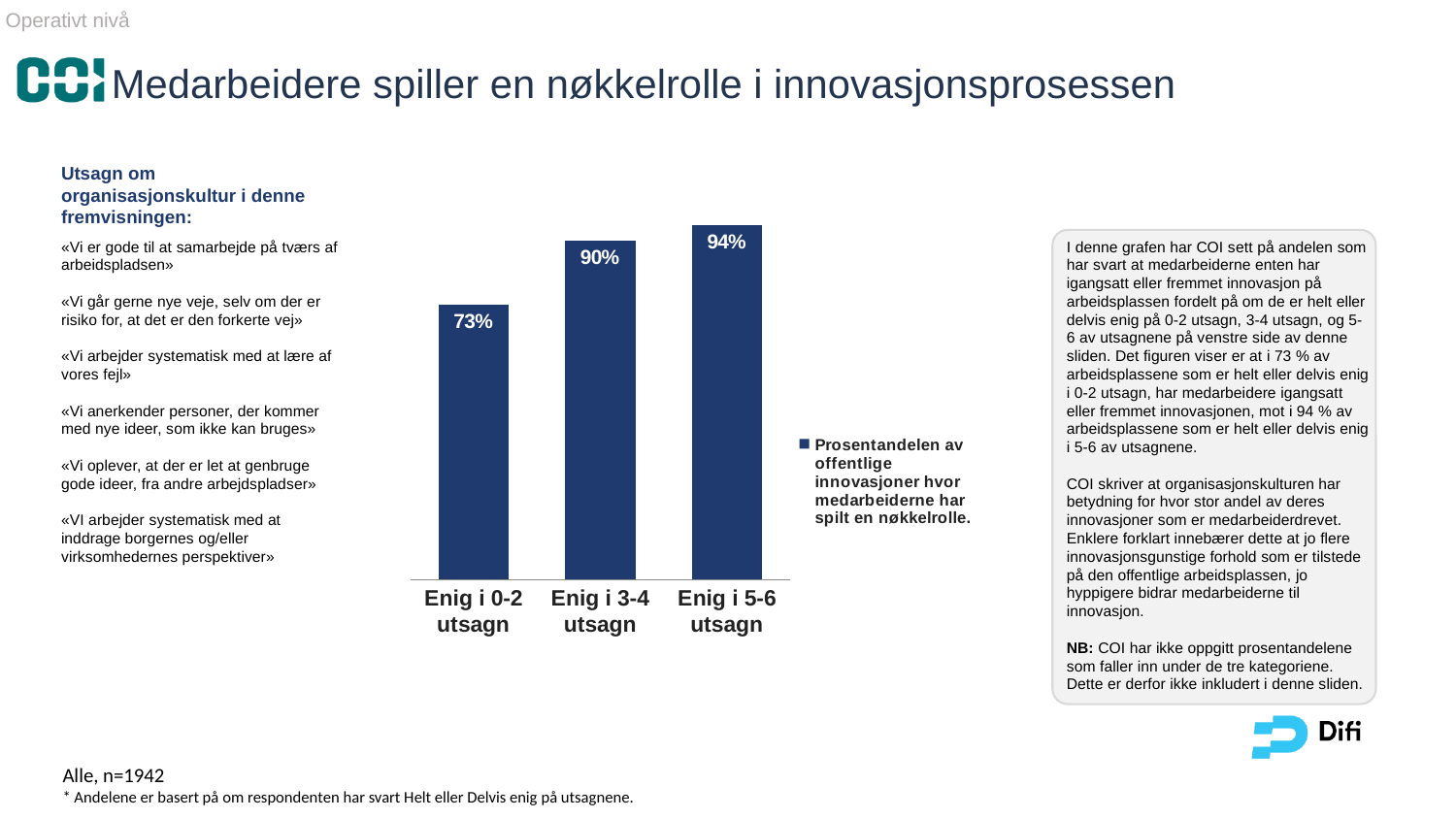
What is the value for 'Enig i 5-6 utsagn'? 94% Which is larger, the value for 'Enig i 3-4 utsagn' or 'Enig i 0-2 utsagn'? Enig i 3-4 utsagn What kind of chart is shown on the slide? Bar chart How many series does the legend list? 1 Do the values rise or fall from left to right along the x axis? Rise What is the difference between the values for 'Enig i 3-4 utsagn' and 'Enig i 0-2 utsagn'? 17 percentage points Which category has the highest value? Enig i 5-6 utsagn Which category has the lowest value? Enig i 0-2 utsagn What is the value for 'Enig i 3-4 utsagn'? 90% What is the difference between the values for 'Enig i 5-6 utsagn' and 'Enig i 0-2 utsagn'? 21 percentage points How many categories are shown on the x axis? 3 What is the value for 'Enig i 0-2 utsagn'? 73%